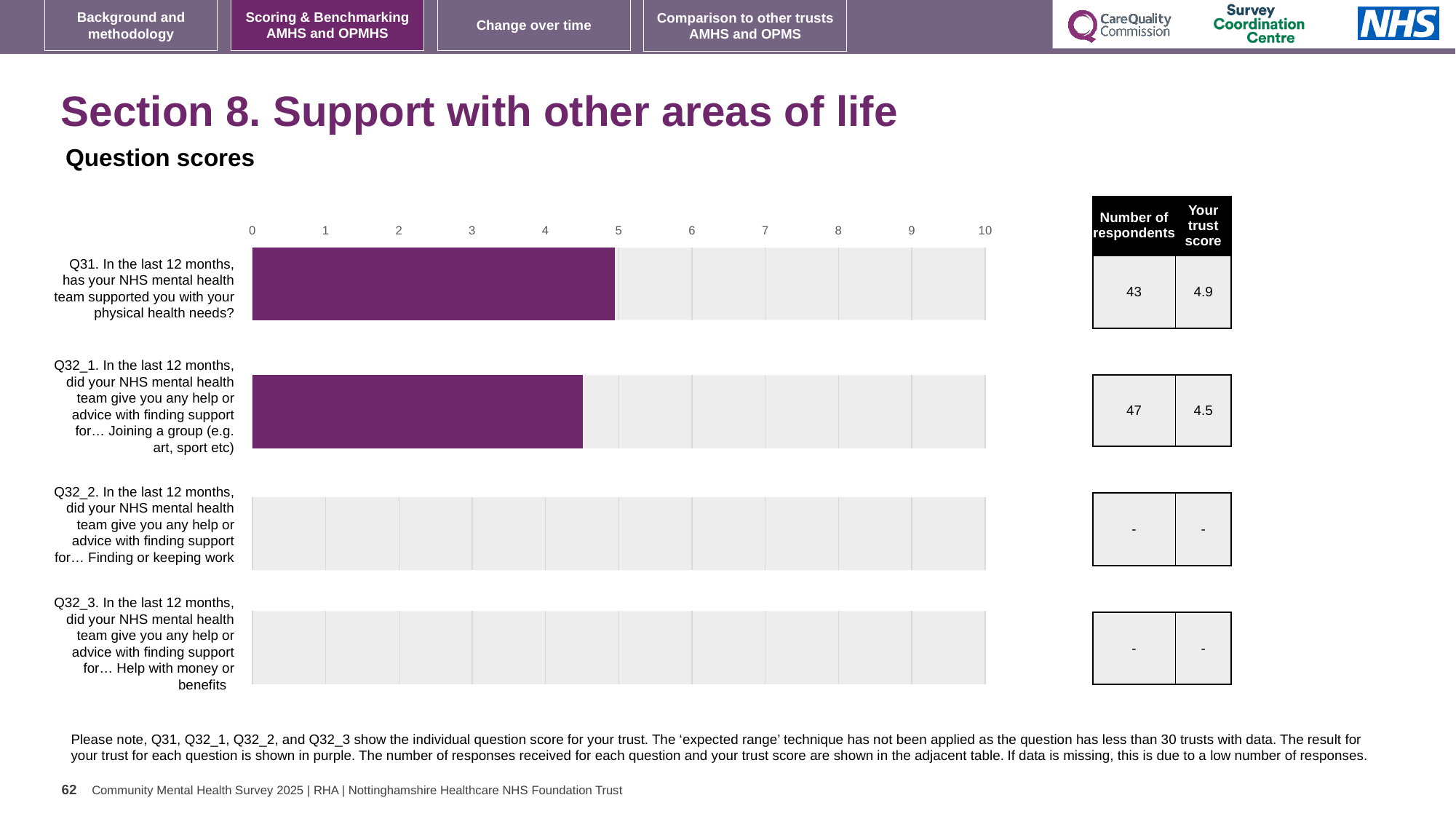
What is the trust score for Q31 (supported you with your physical health needs)? 4.9 Which has the larger trust score, Q31 or Q32_1? Q31 What colour are the bars showing the trust's results? Purple Is the trust score for Q32_1 greater or less than 5? less Which question has the highest trust score shown on the chart? Q31 How many questions are listed on the chart? 4 How many respondents answered Q32_1? 47 What is the difference between the trust scores for Q31 and Q32_1? 0.4 What is the maximum value shown on the chart's axis? 10 What is the trust score for Q32_1 (help or advice with finding support for joining a group)? 4.5 What type of chart is shown on the slide? Bar chart How many respondents answered Q31? 43